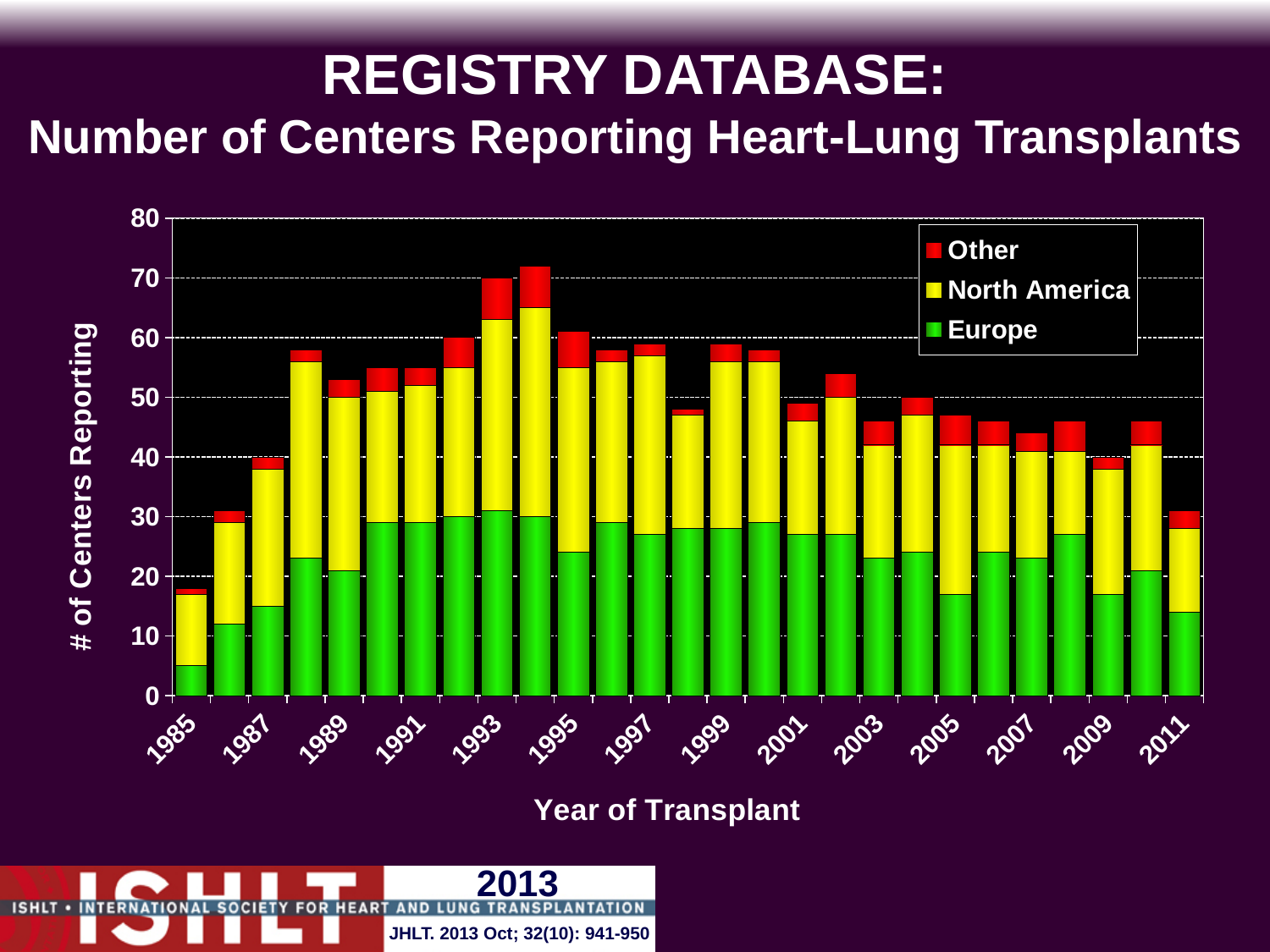
Which year has the lowest total number of centers reporting? 1985 Is the number of Europe centers reporting in 1985 greater or less than 10? less Which year has the highest total number of centers reporting? 1994 Which series are listed in the legend? Other, North America, Europe Is the total number of centers reporting in 1994 greater or less than 70? greater Is the total number of centers reporting in 1985 greater or less than 20? less Which year has a larger total number of centers reporting, 1988 or 2011? 1988 Do the total numbers of centers reporting generally rise or fall from 1994 to 2011? fall How many series does the legend list? 3 How many years (bars) are plotted in the chart? 27 What kind of chart is shown on the slide? Stacked bar chart What is the label of the x axis? Year of Transplant